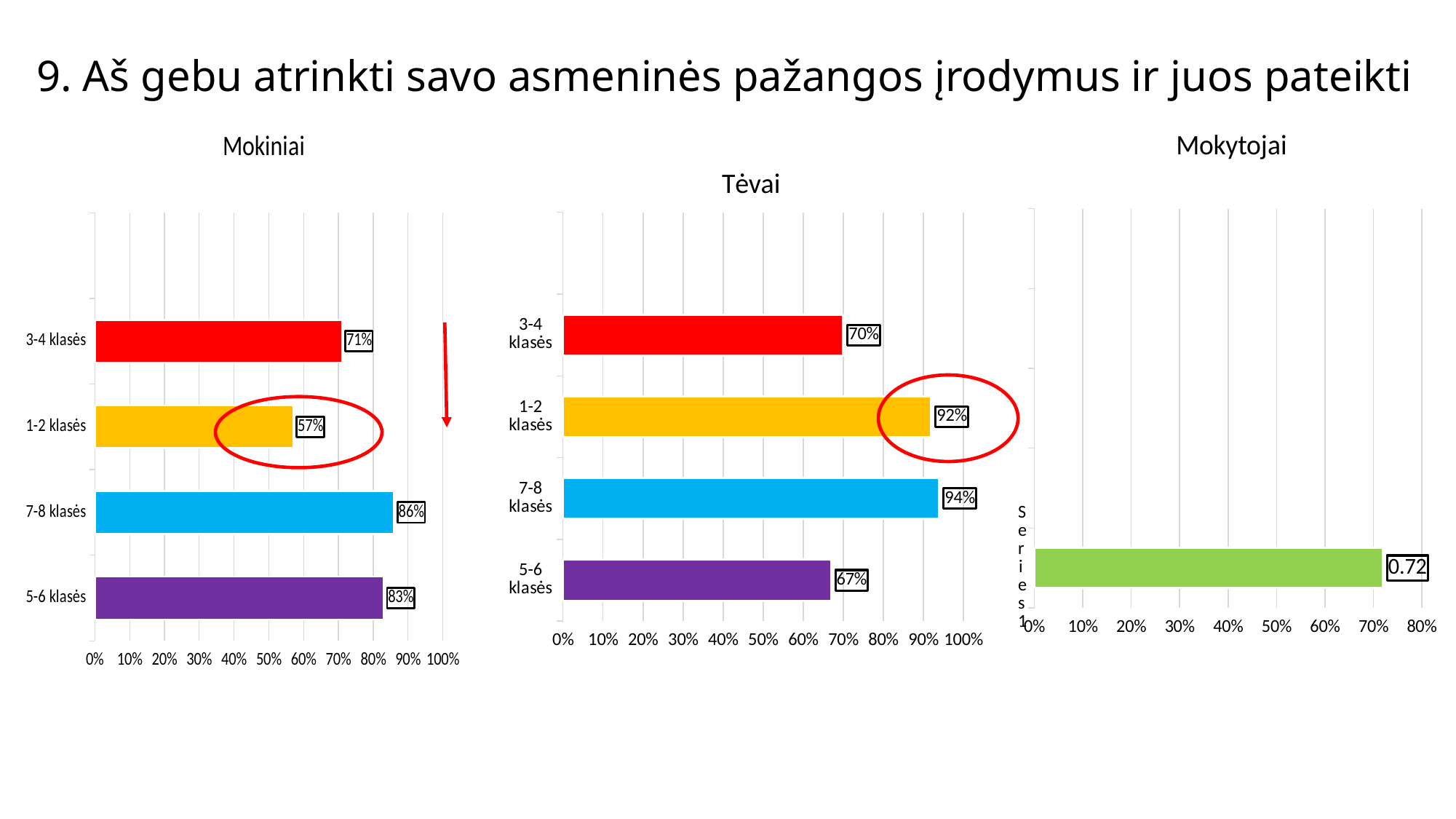
In the Tėvai chart, what is the value for 3-4 klasės? 70% Which is larger: the value for 1-2 klasės in the Mokiniai chart or the value for 1-2 klasės in the Tėvai chart? Tėvai In the Mokiniai chart, what is the difference between the values for 7-8 klasės and 5-6 klasės? 3% In the Mokiniai chart, which category has the highest value? 7-8 klasės In the Tėvai chart, which category has the highest value? 7-8 klasės In the Mokiniai chart, what is the value for 1-2 klasės? 57% In the Tėvai chart, which category has the lowest value? 5-6 klasės What type of chart is the Mokiniai chart? Bar chart In the Mokiniai chart, which category has the lowest value? 1-2 klasės In the Mokytojai chart, what is the value shown on the bar? 0.72 How many categories does the Tėvai chart show? 4 In the Tėvai chart, what is the difference between the values for 1-2 klasės and 3-4 klasės? 22%